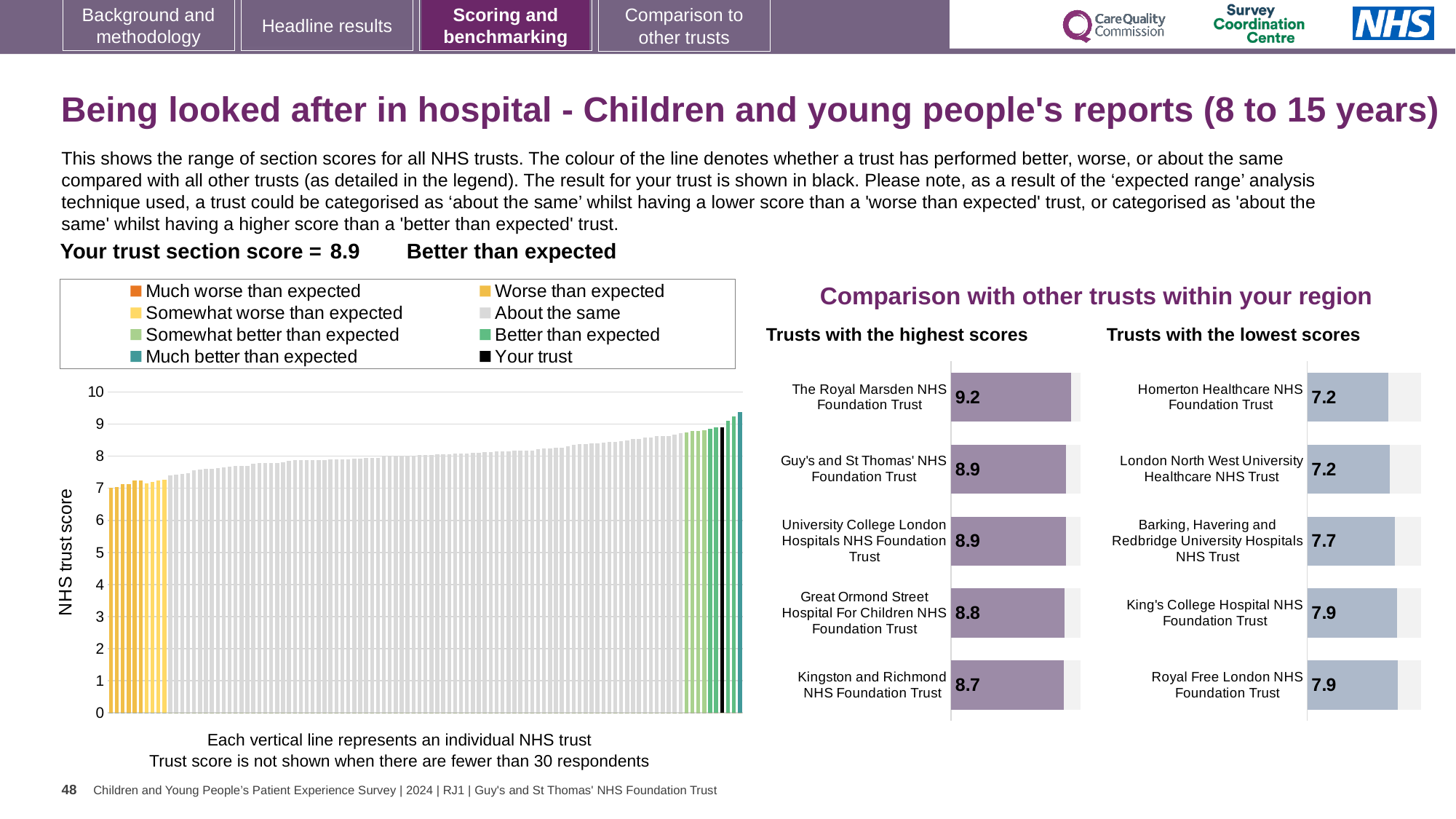
How many entries does the legend of the large chart on the left list? 8 In the 'Trusts with the lowest scores' chart, what is the score for Barking, Havering and Redbridge University Hospitals NHS Trust? 7.7 In the large chart on the left, is the value of the leftmost bar greater or less than 8? less In the large chart on the left, do the NHS trust scores rise or fall from left to right? Rise How many trusts are listed in the 'Trusts with the lowest scores' chart? 5 In the 'Trusts with the lowest scores' chart, which has the larger score: Barking, Havering and Redbridge University Hospitals NHS Trust or Homerton Healthcare NHS Foundation Trust? Barking, Havering and Redbridge University Hospitals NHS Trust In the 'Trusts with the highest scores' chart, which trust has the highest score? The Royal Marsden NHS Foundation Trust In the 'Trusts with the highest scores' chart, which trust has the lowest score? Kingston and Richmond NHS Foundation Trust In the 'Trusts with the highest scores' chart, what is the difference between the scores of The Royal Marsden NHS Foundation Trust and Kingston and Richmond NHS Foundation Trust? 0.5 What kind of chart is the large chart on the left showing NHS trust scores? Bar chart In the 'Trusts with the lowest scores' chart, what is the difference between the scores of Royal Free London NHS Foundation Trust and Homerton Healthcare NHS Foundation Trust? 0.7 In the 'Trusts with the highest scores' chart, what is the score for The Royal Marsden NHS Foundation Trust? 9.2